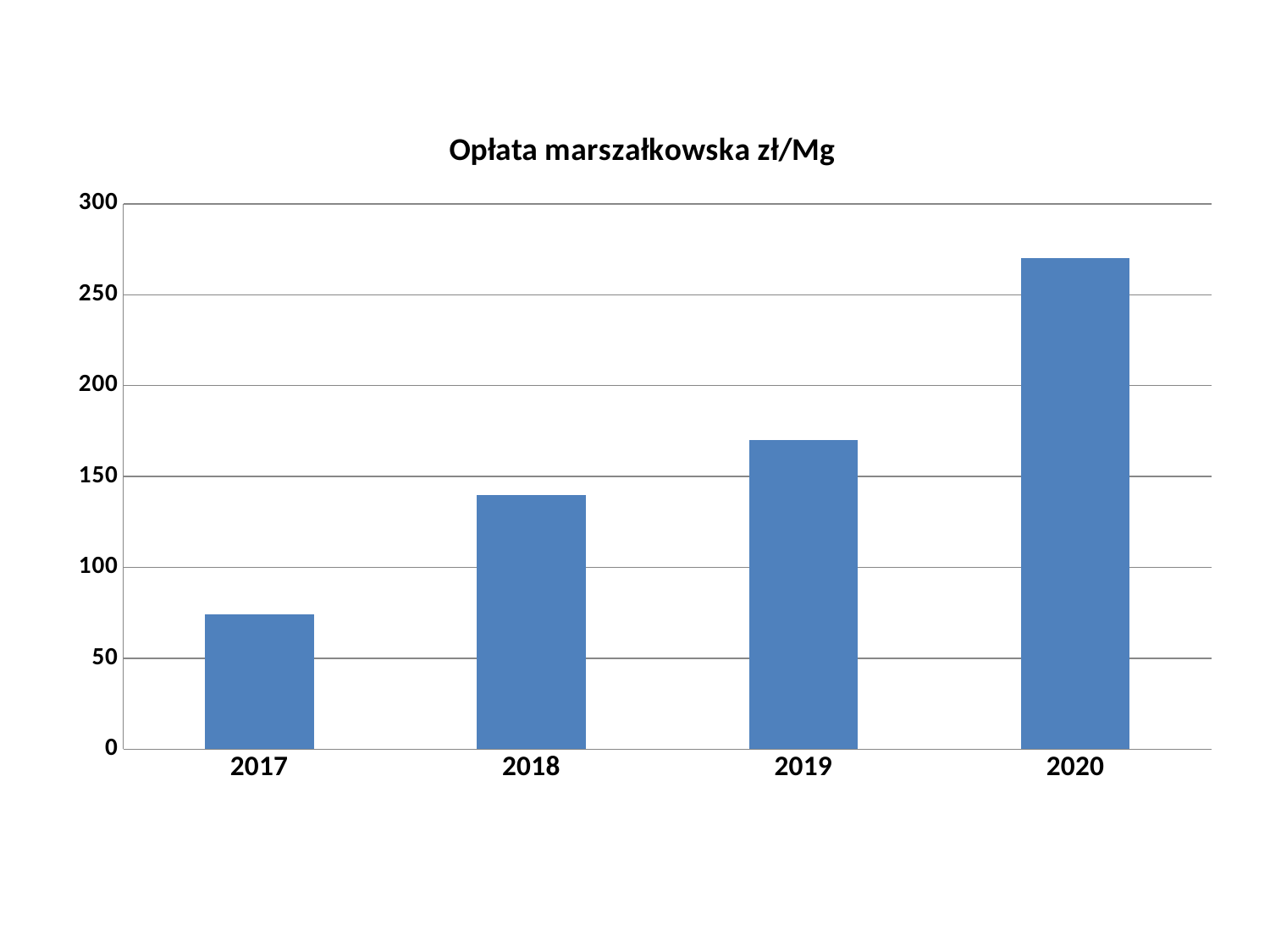
Which year has the highest value in the chart? 2020 What is the title of the chart? Opłata marszałkowska zł/Mg Is the value for 2017 greater or less than 50? greater Is the value for 2020 greater or less than 250? greater Which year has the lowest value in the chart? 2017 What type of chart is shown on the slide? bar chart Which is larger, the value for 2018 or the value for 2019? 2019 Is the value for 2019 greater or less than 150? greater Do the values rise or fall from 2017 to 2020? rise How many years are shown on the x axis of the chart? 4